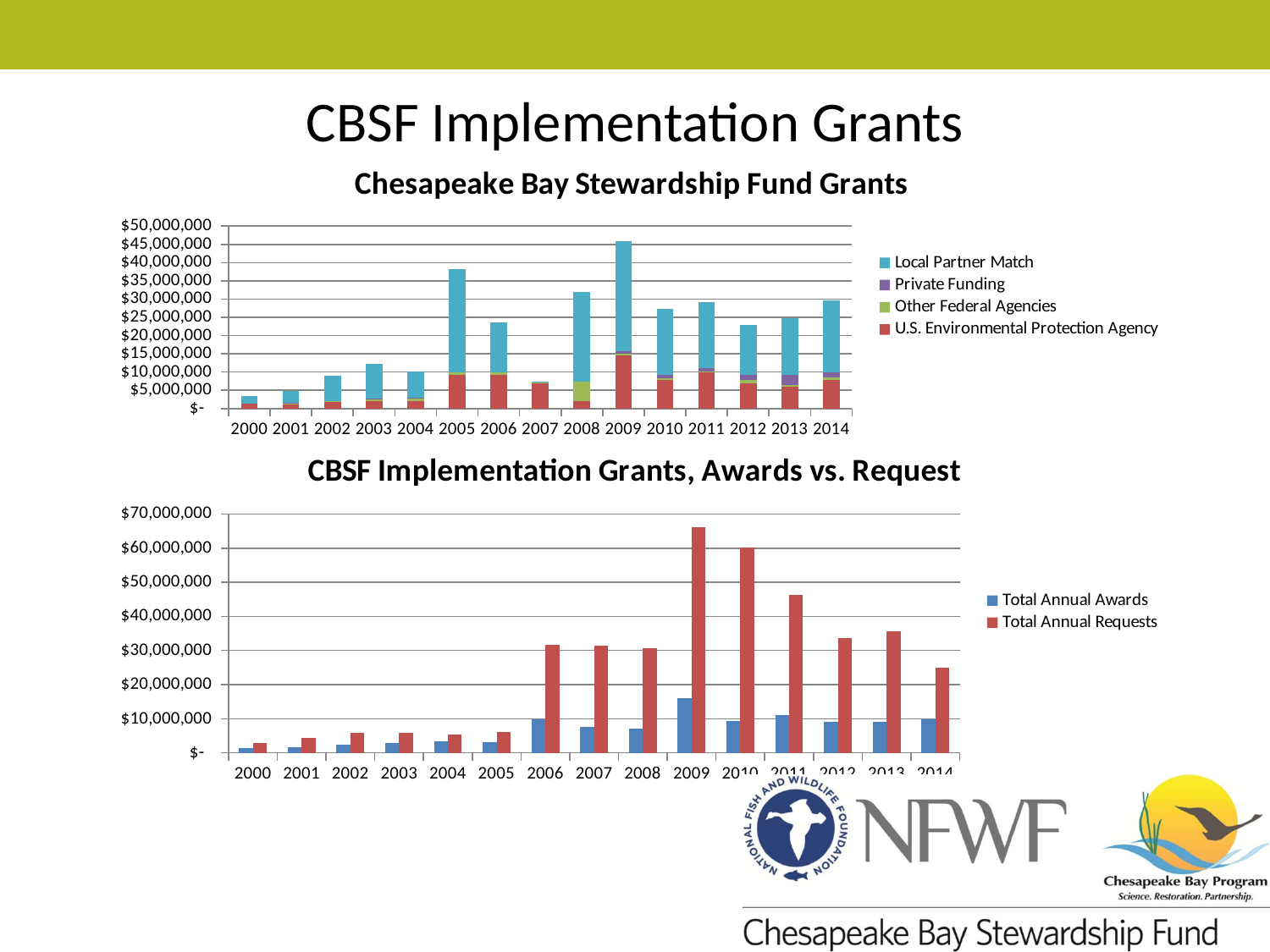
On the 'CBSF Implementation Grants, Awards vs. Request' chart, is the Total Annual Requests value for 2009 greater or less than $60,000,000? greater On the 'Chesapeake Bay Stewardship Fund Grants' chart, is the total bar for 2009 greater or less than $40,000,000? greater On the 'Chesapeake Bay Stewardship Fund Grants' chart, how many series does the legend list? 4 On the 'CBSF Implementation Grants, Awards vs. Request' chart, which year has the highest Total Annual Requests? 2009 On the 'Chesapeake Bay Stewardship Fund Grants' chart, which year has the lowest total bar? 2000 On the 'Chesapeake Bay Stewardship Fund Grants' chart, which year has the highest total bar? 2009 On the 'CBSF Implementation Grants, Awards vs. Request' chart, how many series does the legend list? 2 On the 'Chesapeake Bay Stewardship Fund Grants' chart, how many years are shown on the x axis? 15 On the 'CBSF Implementation Grants, Awards vs. Request' chart, is the Total Annual Awards value for 2007 greater or less than $10,000,000? less On the 'Chesapeake Bay Stewardship Fund Grants' chart, what kind of chart is shown? Stacked bar chart On the 'Chesapeake Bay Stewardship Fund Grants' chart, which series is shown in blue at the top of each stacked bar? Local Partner Match On the 'CBSF Implementation Grants, Awards vs. Request' chart, which is larger: Total Annual Requests in 2010 or in 2011? 2010